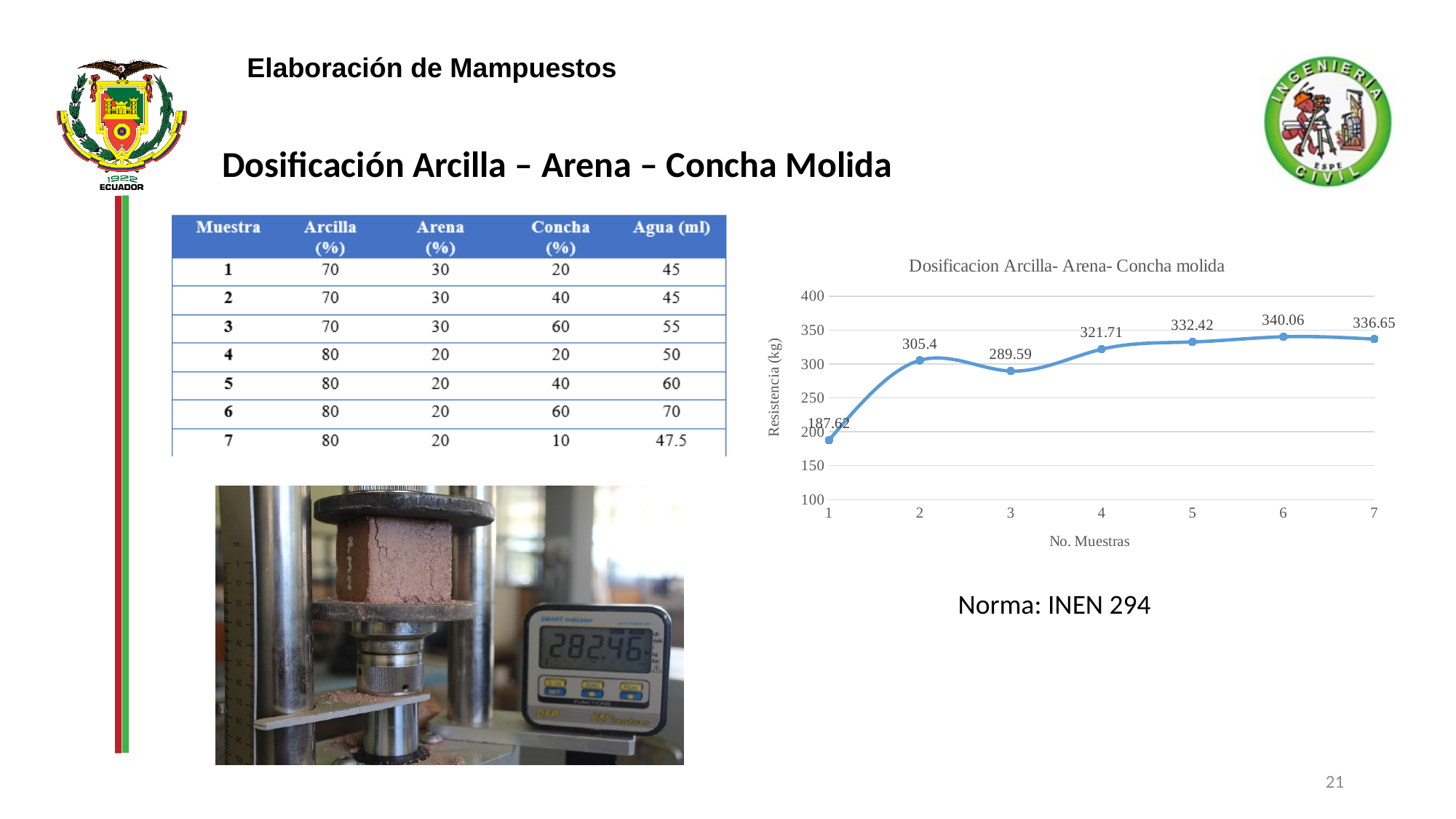
Which has a higher Resistencia (kg): sample 4 or sample 5? Sample 5 Which sample number has the highest Resistencia (kg) in the chart? 6 Does the Resistencia (kg) rise or fall from sample 1 to sample 2? Rise Which sample number has the lowest Resistencia (kg) in the chart? 1 How many samples are plotted in the chart? 7 What is the Resistencia (kg) value for sample 6 in the chart? 340.06 What type of chart is shown on the slide? Line chart What is the Resistencia (kg) value for sample 1 in the chart? 187.62 Is the Resistencia (kg) value for sample 7 greater or less than 300? greater What is the difference in Resistencia (kg) between sample 2 and sample 3? 15.81 What is the title of the chart on the slide? Dosificacion Arcilla- Arena- Concha molida What is the Resistencia (kg) value for sample 3 in the chart? 289.59